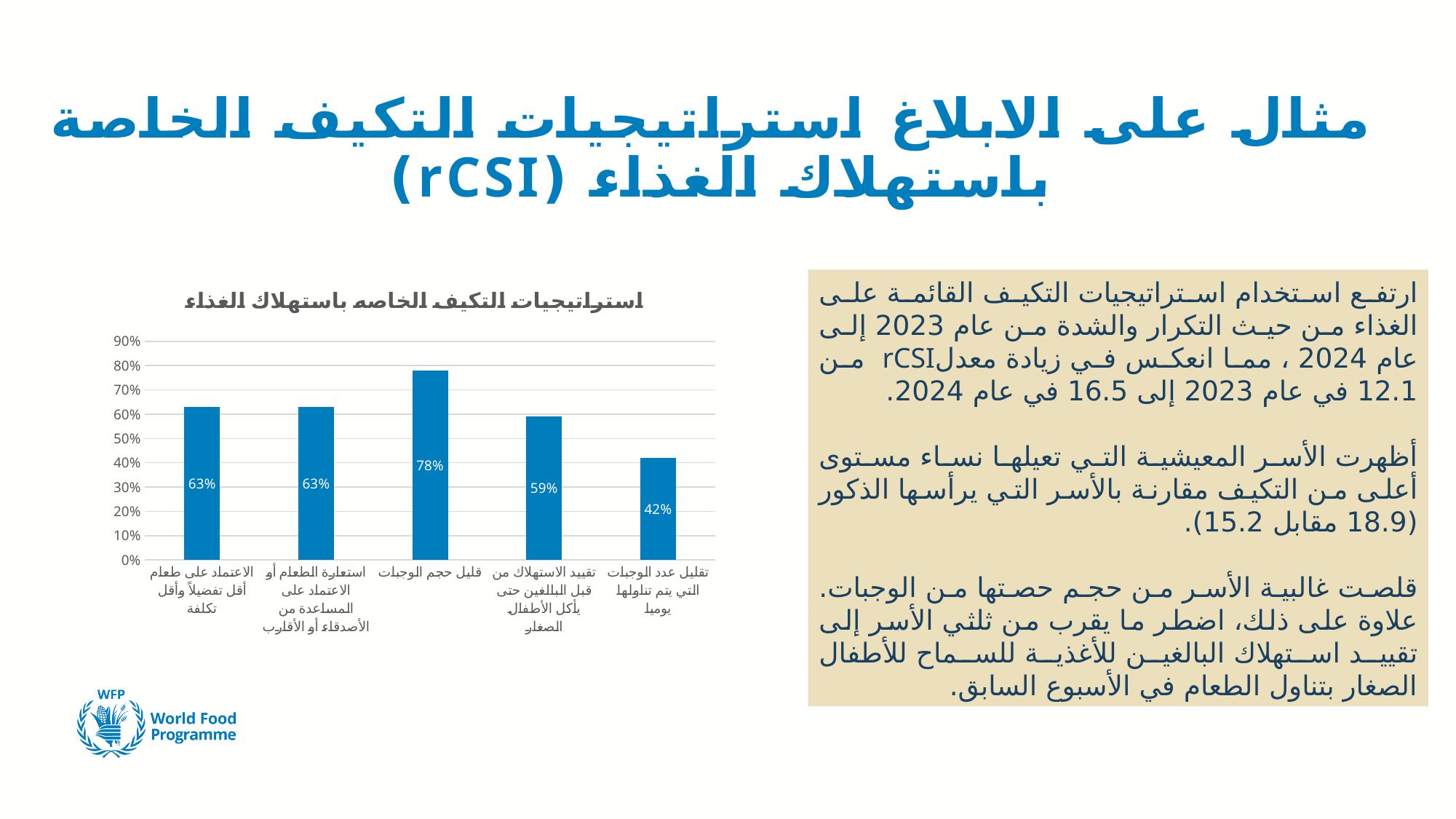
What is the value for "تقليل عدد الوجبات التي يتم تناولها يومياً" in the chart? 42% What is the value for "الاعتماد على طعام أقل تفضيلاً وأقل تكلفة" in the chart? 63% Which category has the lowest value in the chart? تقليل عدد الوجبات التي يتم تناولها يومياً What is the value for "تقليل حجم الوجبات" in the chart? 78% What is the difference between the values for "تقليل حجم الوجبات" and "تقليل عدد الوجبات التي يتم تناولها يومياً"? 36% What kind of chart is shown on the slide? bar chart Is the value for "تقليل عدد الوجبات التي يتم تناولها يومياً" greater or less than 50%? less How many categories are shown in the chart? 5 What is the title of the chart? استراتيجيات التكيف الخاصه باستهلاك الغذاء Which is larger: the value for "تقليل حجم الوجبات" or the value for "تقييد الاستهلاك من قبل البالغين حتى يأكل الأطفال الصغار"? قليل حجم الوجبات Which category has the highest value in the chart? قليل حجم الوجبات What is the value for "تقييد الاستهلاك من قبل البالغين حتى يأكل الأطفال الصغار" in the chart? 59%